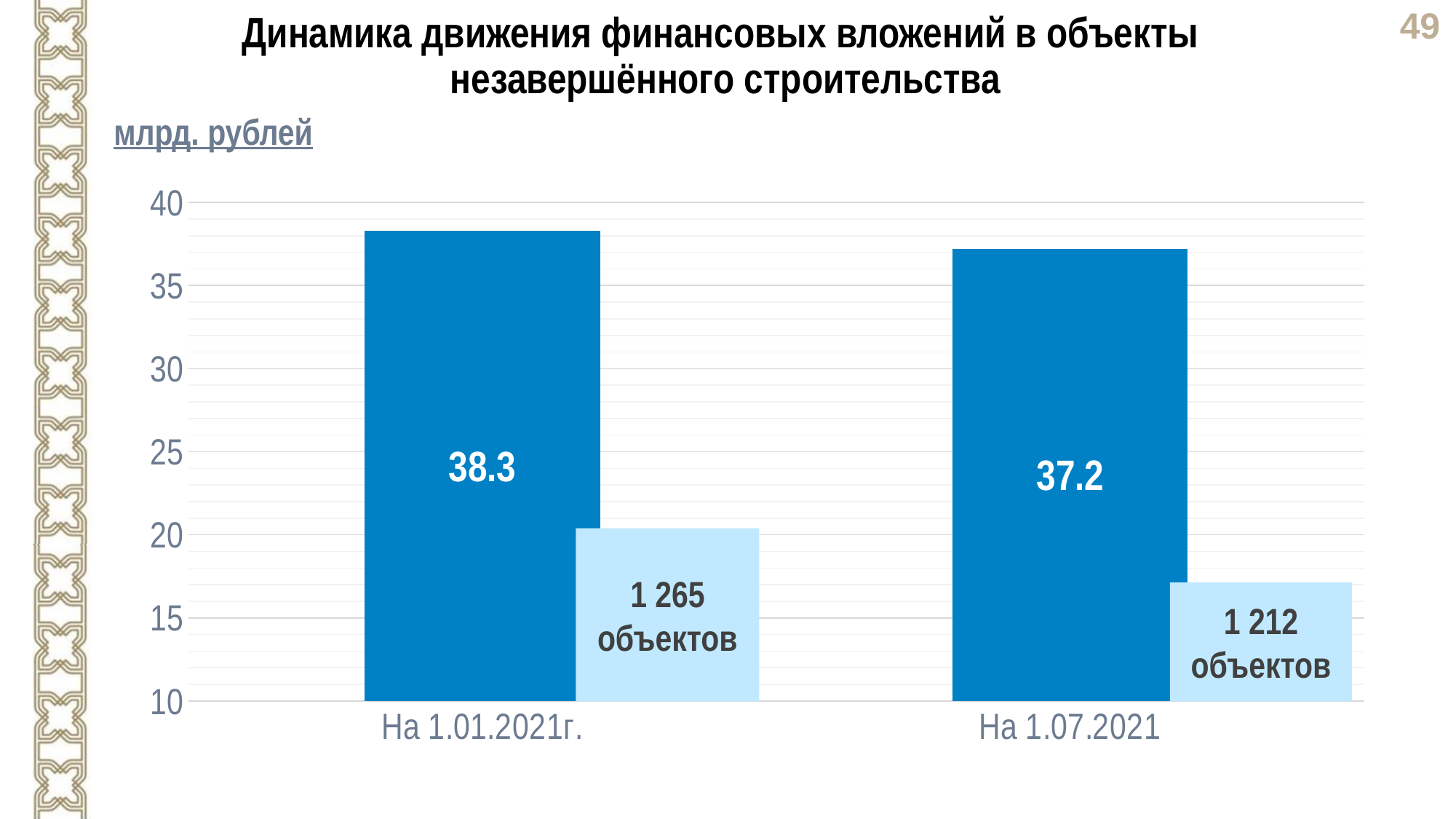
How many dates (categories) are shown on the x axis? 2 What label is printed on the light blue bar for На 1.01.2021г.? 1 265 объектов Is the dark blue bar value larger for На 1.01.2021г. or for На 1.07.2021? На 1.01.2021г. Which date has the lower dark blue bar value? На 1.07.2021 What is the value of the dark blue bar for На 1.01.2021г.? 38.3 What kind of chart is shown on the slide? bar chart What is the difference between the dark blue bar values for На 1.01.2021г. and На 1.07.2021? 1.1 Which date has the higher dark blue bar value? На 1.01.2021г. Is the light blue bar for На 1.01.2021г. greater or less than 25 on the axis? less Is the light blue bar for На 1.07.2021 greater or less than 20 on the axis? less Do the dark blue bar values rise or fall from На 1.01.2021г. to На 1.07.2021? fall What is the value of the dark blue bar for На 1.07.2021? 37.2